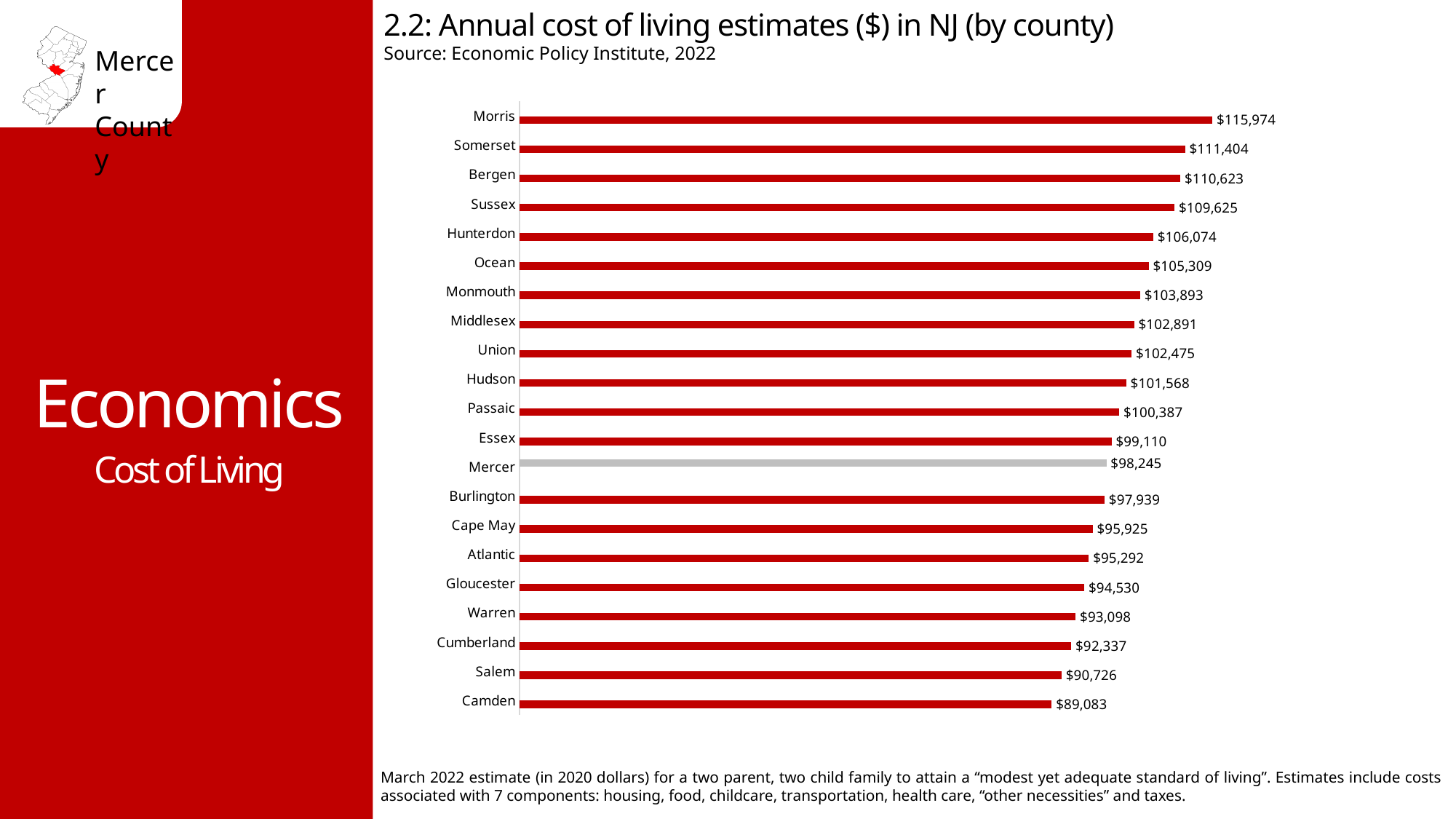
Which county's bar is shown in gray rather than red? Mercer What is the annual cost of living estimate for Cape May County? $95,925 How much higher is Mercer County's cost of living estimate than Burlington County's? $306 What is the annual cost of living estimate for Mercer County? $98,245 What type of chart is used to show the annual cost of living estimates? Bar chart What is the difference between the cost of living estimates for Morris and Camden counties? $26,891 Which county has the highest annual cost of living estimate? Morris How many counties are shown in the chart? 21 Which county has a higher cost of living estimate, Salem or Warren? Warren Which county has the lowest annual cost of living estimate? Camden Which county has a higher cost of living estimate, Ocean or Monmouth? Ocean What is the annual cost of living estimate for Hunterdon County? $106,074